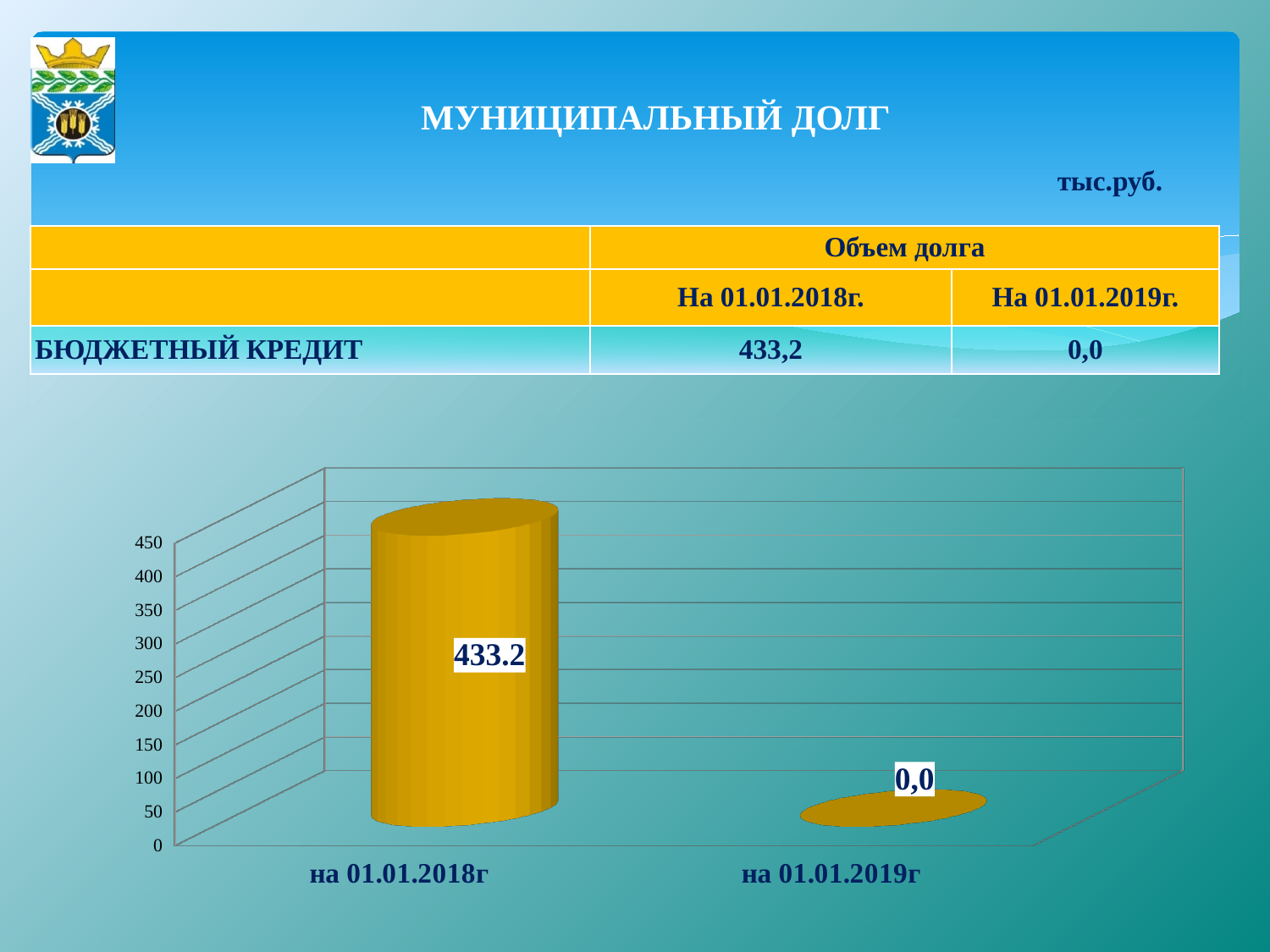
How many categories are shown on the x axis of the chart? 2 What is the value shown for на 01.01.2019г? 0,0 Do the values rise or fall from на 01.01.2018г to на 01.01.2019г? fall Which is larger, the value for на 01.01.2018г or the value for на 01.01.2019г? на 01.01.2018г What is the value shown for на 01.01.2018г? 433.2 Is the value for на 01.01.2018г greater or less than 400? greater What is the title of the slide containing the chart? МУНИЦИПАЛЬНЫЙ ДОЛГ Which category has the highest value? на 01.01.2018г What is the difference between the values for на 01.01.2018г and на 01.01.2019г? 433.2 What kind of chart is shown on the slide? bar chart What is the highest tick value shown on the vertical axis of the chart? 450 Which category has the lowest value? на 01.01.2019г